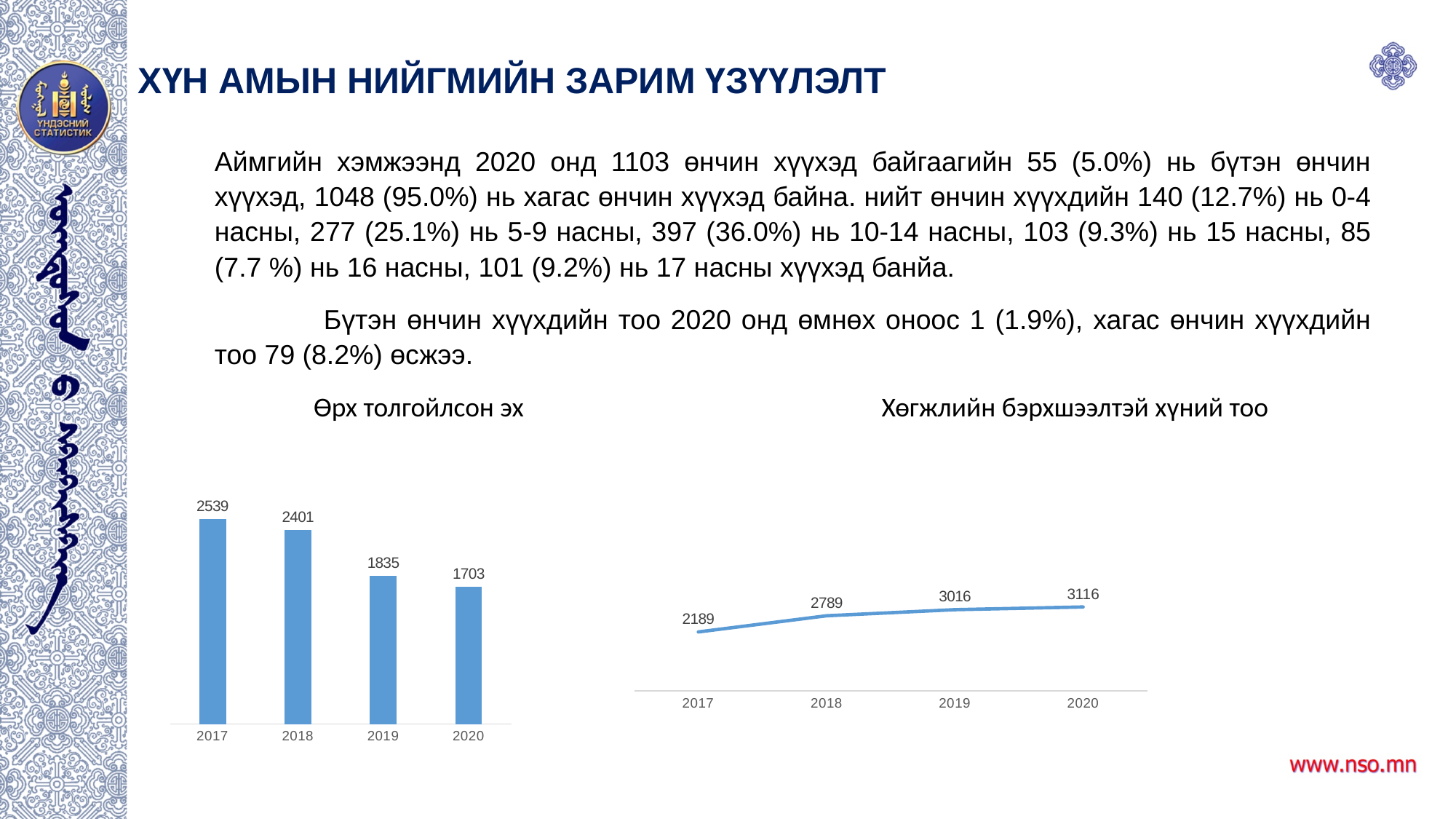
In the 'Хөгжлийн бэрхшээлтэй хүний тоо' chart, which year has the highest value? 2020 In the 'Хөгжлийн бэрхшээлтэй хүний тоо' chart, do the values rise or fall from 2017 to 2020? rise In the 'Өрх толгойлсон эх' chart, what is the difference between the 2018 and 2019 values? 566 In the 'Өрх толгойлсон эх' chart, do the values rise or fall from 2017 to 2020? fall In the 'Өрх толгойлсон эх' chart, what is the value for 2017? 2539 What kind of chart is the 'Өрх толгойлсон эх' chart? bar chart In the 'Хөгжлийн бэрхшээлтэй хүний тоо' chart, what is the difference between the 2020 and 2017 values? 927 In the 'Өрх толгойлсон эх' chart, which year has the lowest value? 2020 In the 'Хөгжлийн бэрхшээлтэй хүний тоо' chart, what is the value for 2018? 2789 In the 'Өрх толгойлсон эх' chart, what is the value for 2020? 1703 How many years are shown on the x axis of the 'Хөгжлийн бэрхшээлтэй хүний тоо' chart? 4 In the 'Өрх толгойлсон эх' chart, which year has the highest value? 2017